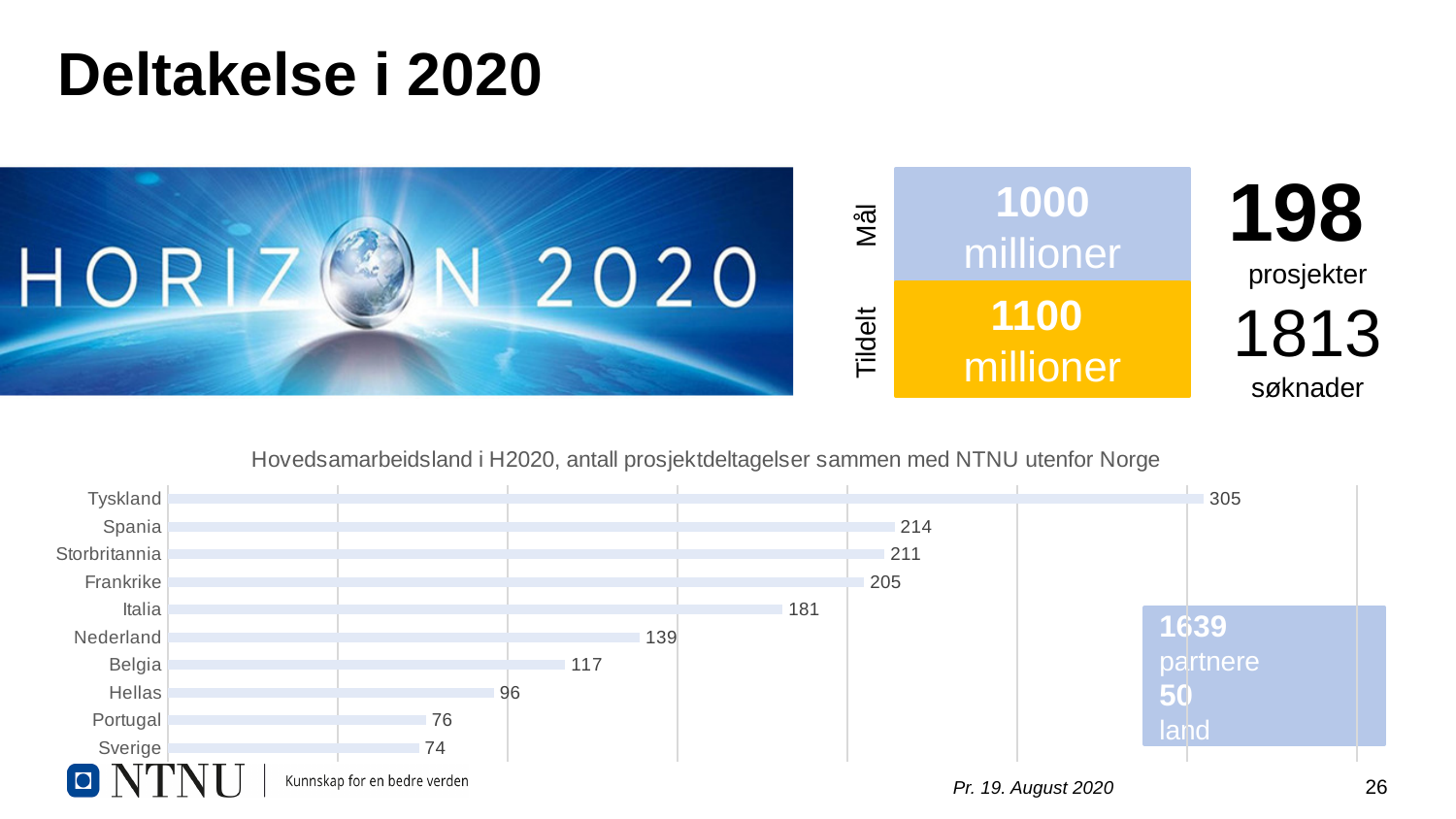
What is the title of the chart? Hovedsamarbeidsland i H2020, antall prosjektdeltagelser sammen med NTNU utenfor Norge What is the difference between the values for Italia and Belgia? 64 What is the value for Nederland in the chart? 139 Which has a larger value, Frankrike or Italia? Frankrike What is the difference between the values for Tyskland and Spania? 91 Which country has the highest value in the chart? Tyskland How many countries are shown in the chart? 10 What is the value for Hellas in the chart? 96 Which has a larger value, Portugal or Hellas? Hellas What is the value for Tyskland in the chart? 305 What kind of chart is shown on the slide? Bar chart Which country has the lowest value in the chart? Sverige